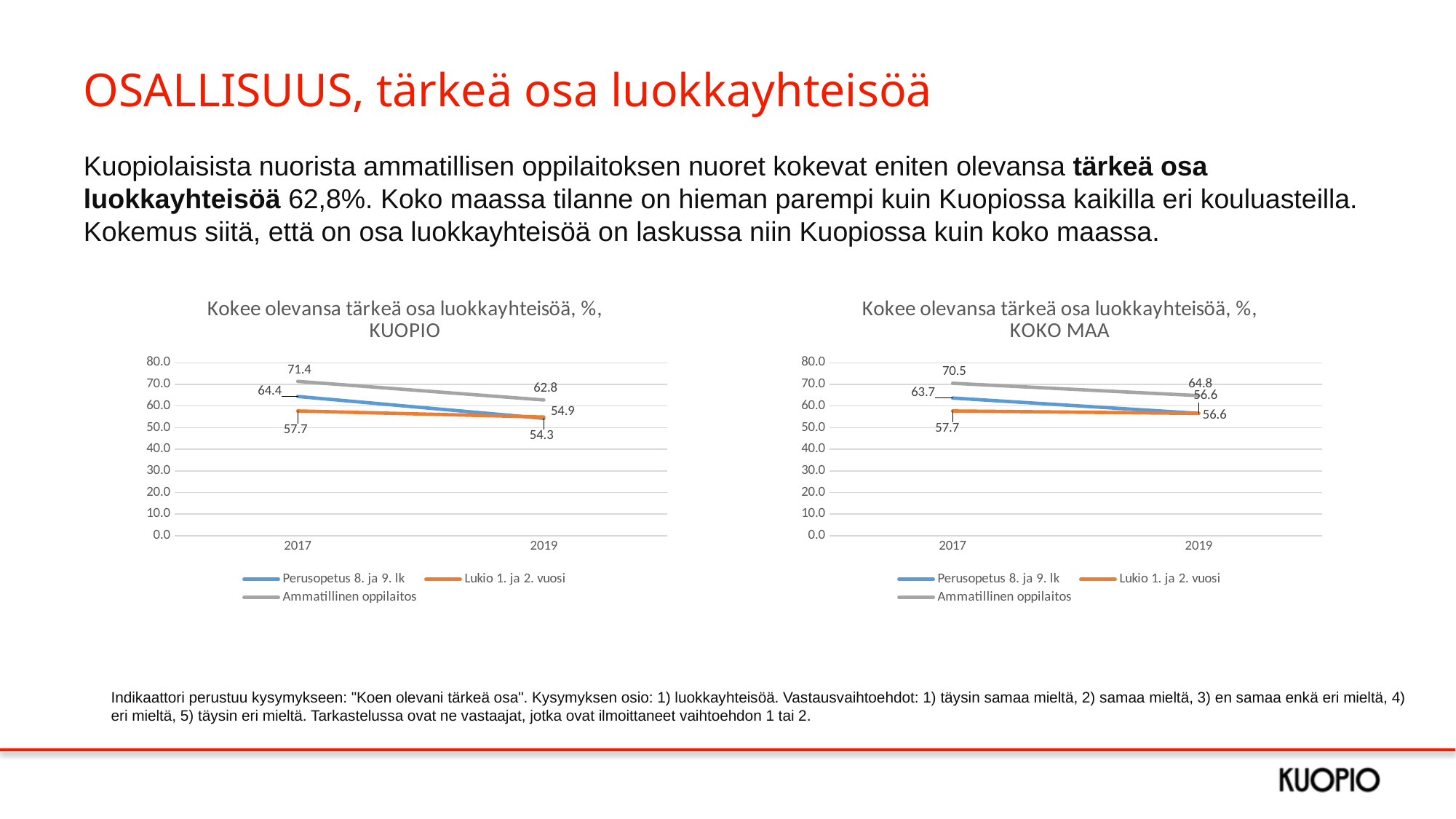
In the KUOPIO chart, what is the value for Ammatillinen oppilaitos in 2017? 71.4 In the KOKO MAA chart, what is the value for Lukio 1. ja 2. vuosi in 2017? 57.7 In the KOKO MAA chart, does the value for Ammatillinen oppilaitos rise or fall from 2017 to 2019? fall In the KOKO MAA chart, what is the value for Ammatillinen oppilaitos in 2019? 64.8 In the KOKO MAA chart, what is the difference between Ammatillinen oppilaitos and Perusopetus 8. ja 9. lk in 2017? 6.8 In the KUOPIO chart, by how much did the value for Ammatillinen oppilaitos fall from 2017 to 2019? 8.6 What type of chart is the KOKO MAA chart? line chart In the KUOPIO chart, which series has the lowest value in 2019? Perusopetus 8. ja 9. lk How many series does the legend of the KUOPIO chart list? 3 In the KUOPIO chart, which series has the highest value in 2017? Ammatillinen oppilaitos In the KUOPIO chart, what is the value for Perusopetus 8. ja 9. lk in 2019? 54.3 In the KUOPIO chart, is the 2017 value for Perusopetus 8. ja 9. lk larger or smaller than the 2017 value for Lukio 1. ja 2. vuosi? larger